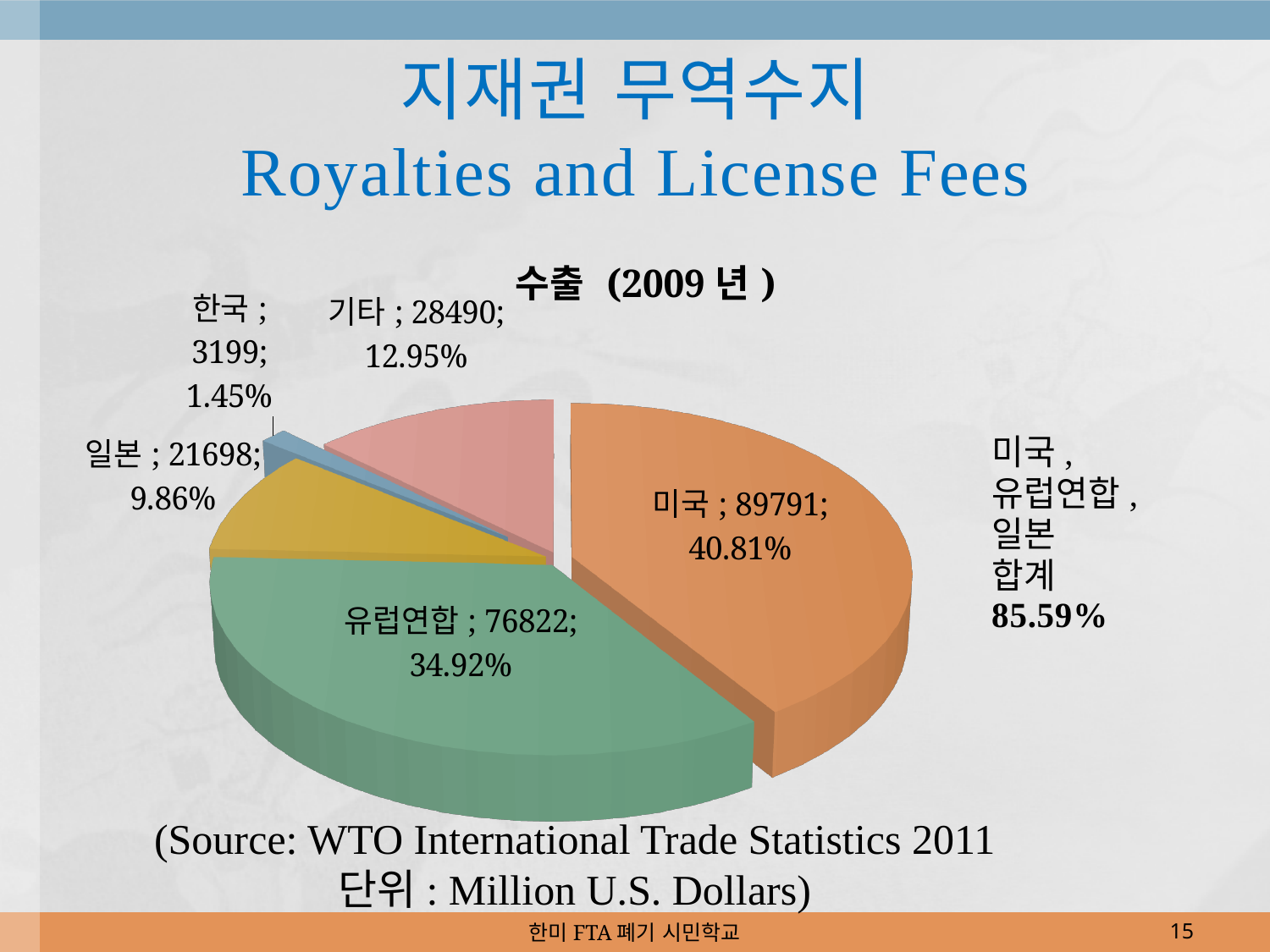
Which category has the smallest slice? 한국 What share of the pie does 기타 represent? 12.95% What is the value for 한국? 3199 Which category has the largest slice? 미국 What is the value for 미국? 89791 What is the value for 유럽연합? 76822 What kind of chart is shown on the slide? pie chart What is the title of the chart? 수출 (2009 년) What is the difference between the values for 미국 and 유럽연합? 12969 What share of the pie does 미국 represent? 40.81% What is the value for 일본? 21698 How many slices does the pie chart have? 5